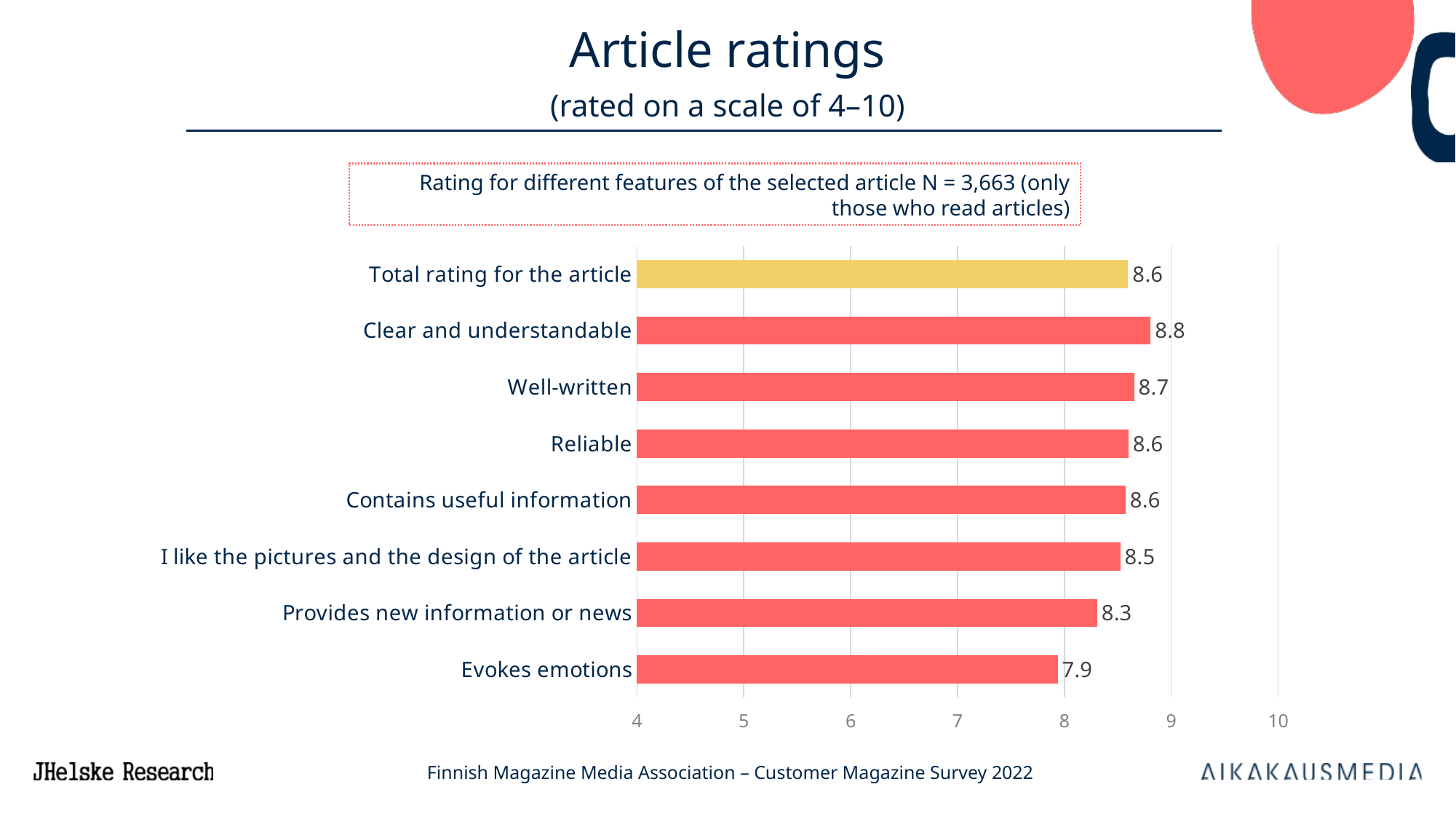
What is the difference between the ratings for "Clear and understandable" and "Evokes emotions"? 0.9 Which feature has the lowest rating? Evokes emotions What is the total rating for the article? 8.6 Which feature has the highest rating? Clear and understandable What is the rating for "Evokes emotions"? 7.9 What is the sample size (N) stated in the chart's caption? 3,663 How many categories are shown in the chart? 8 What kind of chart is shown on the slide? Bar chart Which has a higher rating, "Well-written" or "Provides new information or news"? Well-written What is the rating for "Clear and understandable"? 8.8 What is the rating for "Provides new information or news"? 8.3 Is the rating for "Evokes emotions" greater or less than 8? less